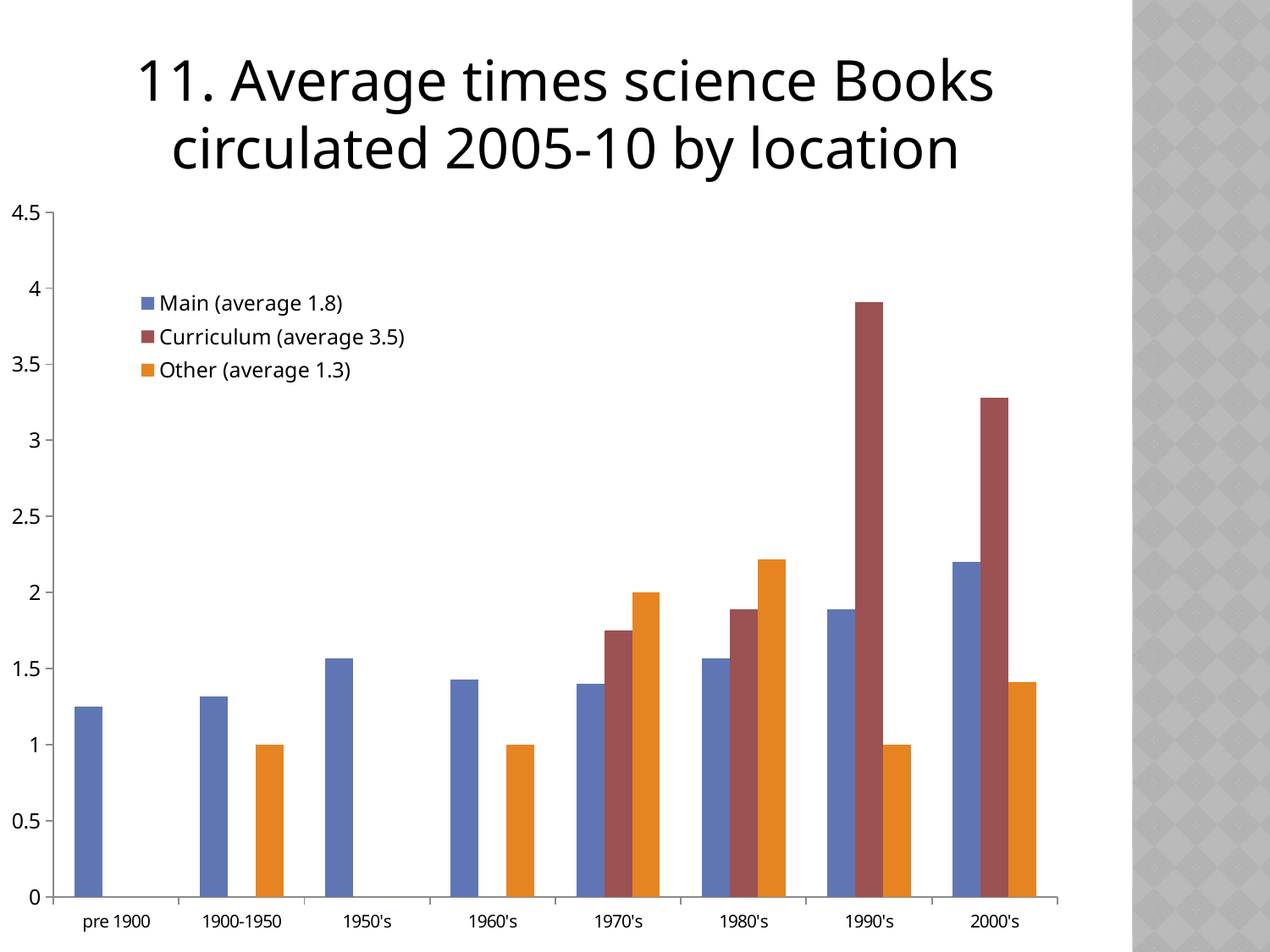
In which decade is the Curriculum bar the highest? 1990's For the 1990's, which is larger: the Main bar or the Curriculum bar? Curriculum Is the Main value for pre 1900 greater or less than 1.5? less What is the Other value for the 1990's? 1 What is the Other value for the 1970's? 2 How many series does the legend list? 3 Do the Curriculum values rise or fall from the 1970's to the 1990's? rise Is the Curriculum value for the 1990's greater or less than 3.5? greater Is the Main value for the 2000's greater or less than 2? greater What average does the legend give for the Curriculum series? 3.5 What kind of chart is shown on the slide? bar chart How many categories are shown along the x axis? 8